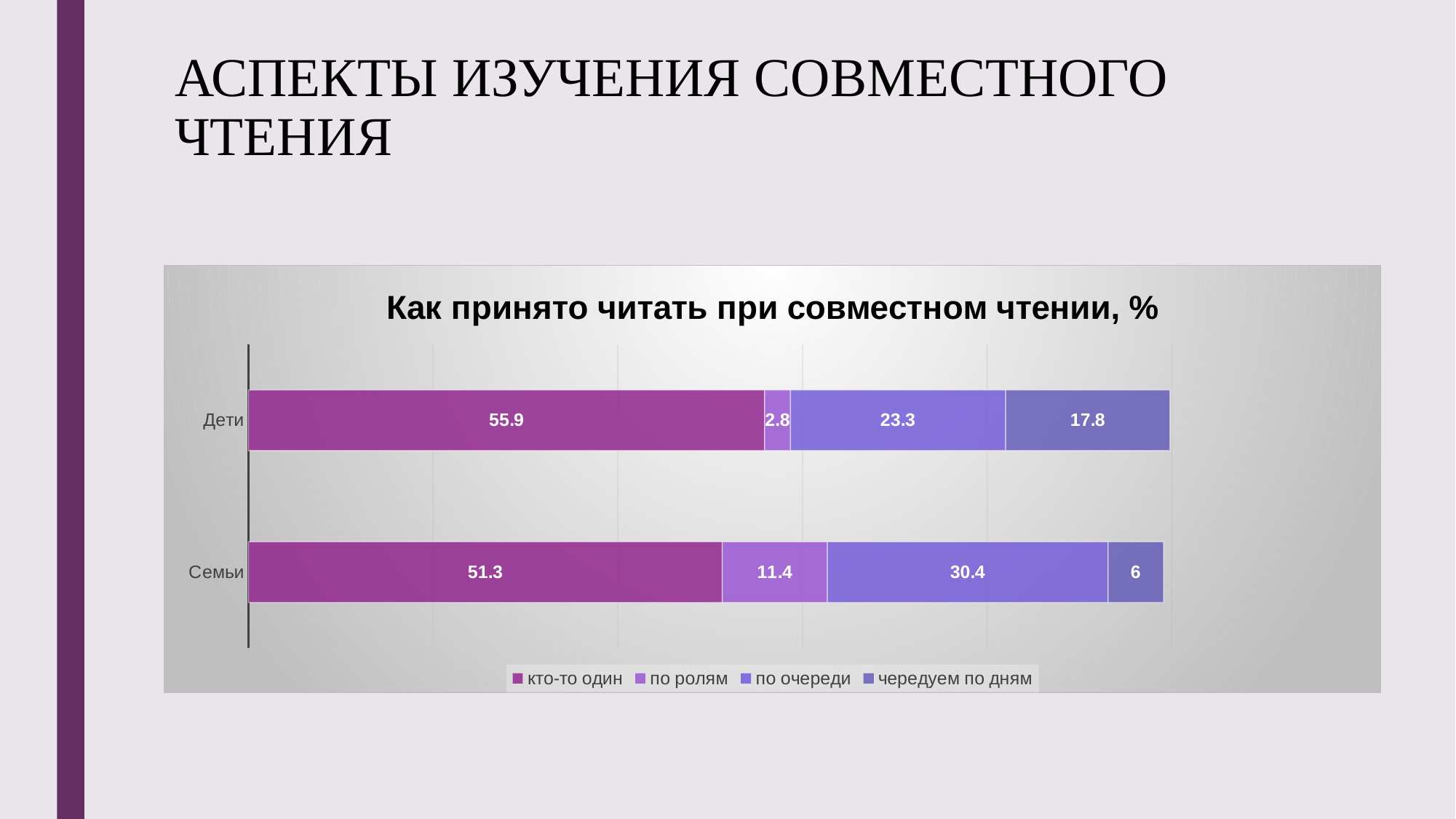
How many series does the legend list? 4 What is the value of 'по очереди' for Дети? 23.3 Which series has the highest value for Семьи? кто-то один What is the value of 'кто-то один' for Дети? 55.9 What is the title of the chart? Как принято читать при совместном чтении, % What type of chart is shown on the slide? stacked bar chart What is the value of 'чередуем по дням' for Семьи? 6 Which is larger: 'чередуем по дням' for Дети or for Семьи? Дети What is the difference between the 'по очереди' values for Семьи and Дети? 7.1 Which series has the lowest value for Дети? по ролям How many categories are shown on the chart? 2 What is the value of 'по ролям' for Семьи? 11.4